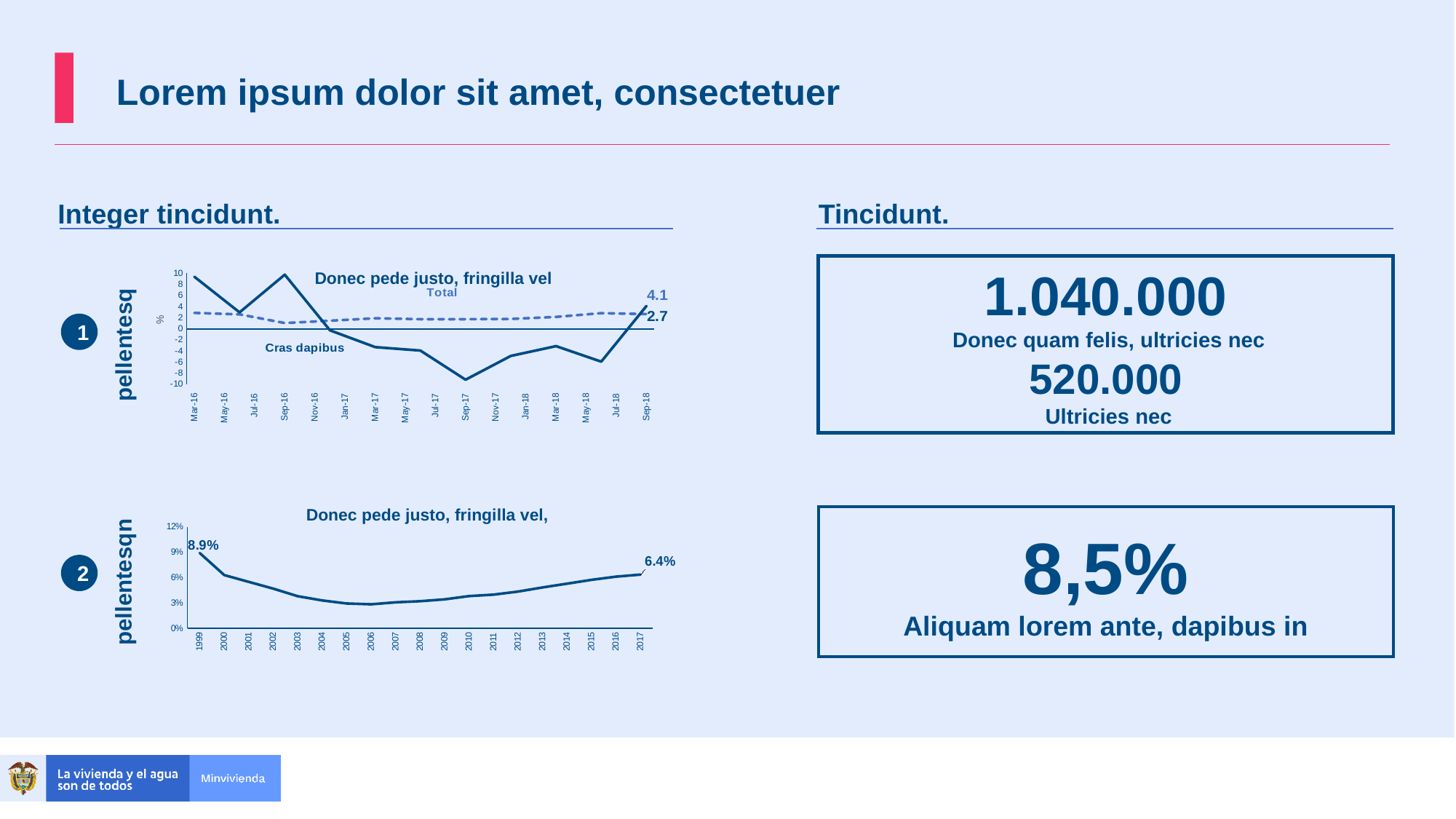
What kind of chart is the top chart titled 'Donec pede justo, fringilla vel'? line chart In the bottom chart 'Donec pede justo, fringilla vel,', what is the value labelled for 1999? 8.9% In the top chart 'Donec pede justo, fringilla vel', at which date does the solid Cras dapibus line reach its lowest point? Sep-17 In the top chart 'Donec pede justo, fringilla vel', what is the higher of the two values labelled at Sep-18? 4.1 In the top chart 'Donec pede justo, fringilla vel', is the Cras dapibus value at Sep-17 greater or less than -5? less In the top chart 'Donec pede justo, fringilla vel', how many series are shown? 2 In the bottom chart 'Donec pede justo, fringilla vel,', by how many percentage points is the 1999 value higher than the 2017 value? 2.5 In the top chart 'Donec pede justo, fringilla vel', what are the names of the two series? Total and Cras dapibus In the bottom chart 'Donec pede justo, fringilla vel,', is the value for 2005 greater or less than 6%? less In the bottom chart 'Donec pede justo, fringilla vel,', what is the value labelled for 2017? 6.4% In the top chart 'Donec pede justo, fringilla vel', is the Cras dapibus value at Sep-16 greater or less than 5? greater In the top chart 'Donec pede justo, fringilla vel', how many dates are labelled on the x axis? 16